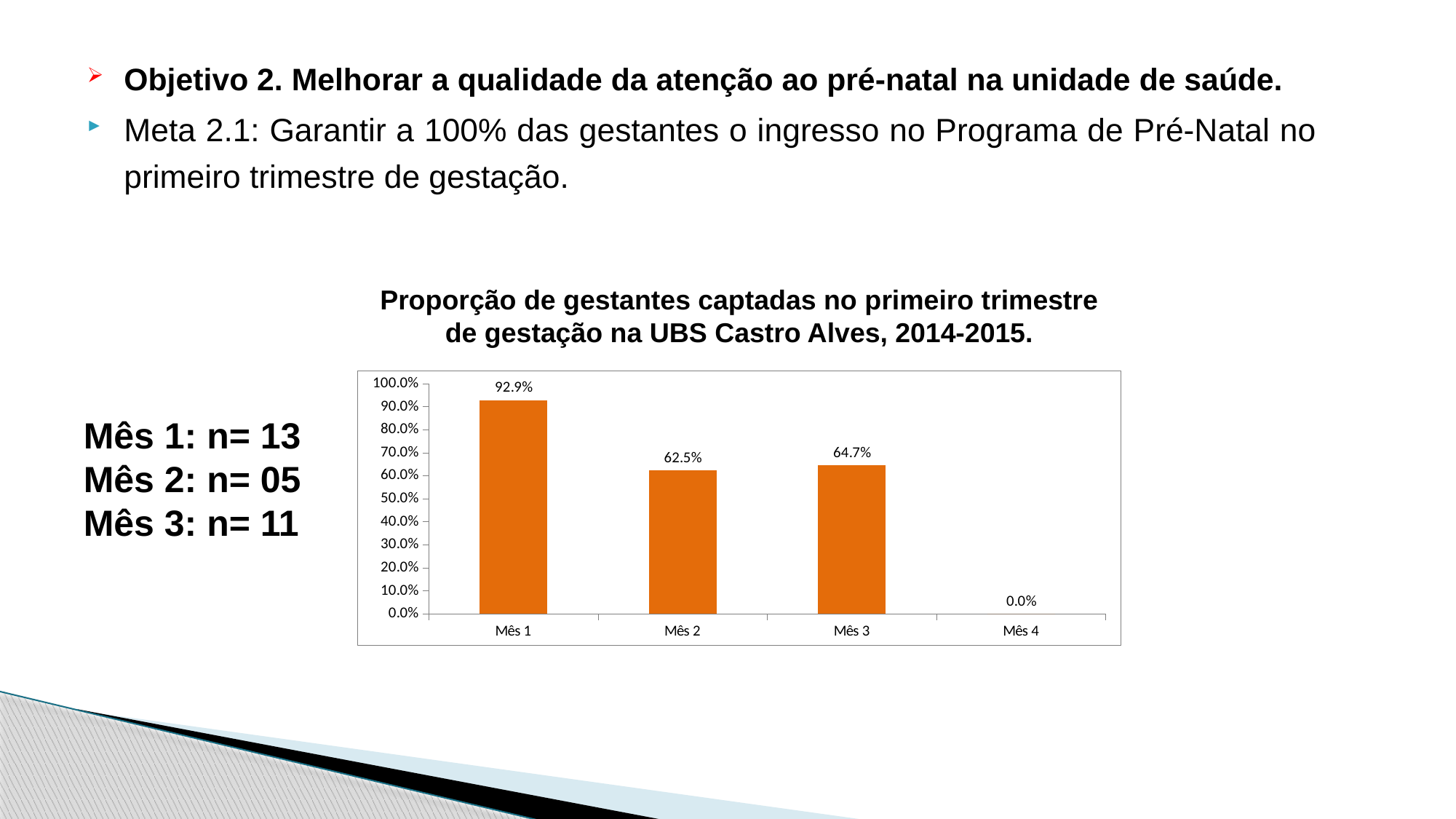
What is the value for Mês 1? 92.9% What kind of chart is shown on the slide? Bar chart Which is larger, the value for Mês 1 or the value for Mês 3? Mês 1 How many categories are shown on the x axis? 4 What is the value for Mês 2? 62.5% What is the difference between the values for Mês 1 and Mês 2? 30.4% Which month has the lowest value? Mês 4 What is the value for Mês 3? 64.7% Which month has the highest value? Mês 1 What is the difference between the values for Mês 3 and Mês 2? 2.2% What is the title of the chart? Proporção de gestantes captadas no primeiro trimestre de gestação na UBS Castro Alves, 2014-2015. What is the value for Mês 4? 0.0%